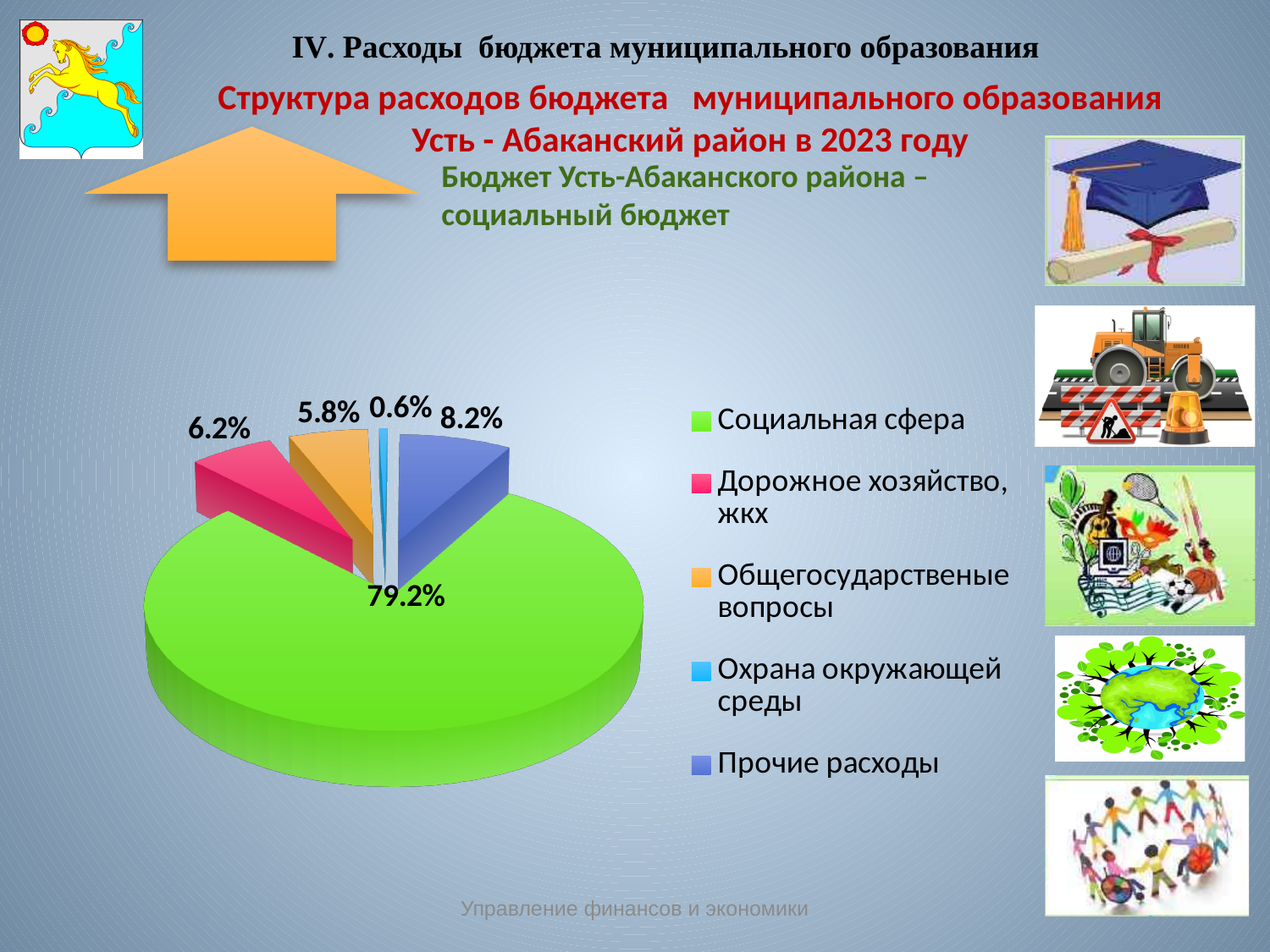
What is the value shown for Общегосударственые вопросы? 5.8% What is the value shown for Охрана окружающей среды? 0.6% What kind of chart is shown on the slide? pie chart What colour is the slice for Социальная сфера? green What share of the pie does Социальная сфера have? 79.2% How many categories does the pie chart have? 5 What is the value shown for Прочие расходы? 8.2% Which is larger, the share for Прочие расходы or the share for Дорожное хозяйство, жкх? Прочие расходы What is the value shown for Дорожное хозяйство, жкх? 6.2% Which category has the largest share of the pie? Социальная сфера Which category has the smallest share of the pie? Охрана окружающей среды What is the difference between the shares for Прочие расходы and Общегосударственые вопросы? 2.4%